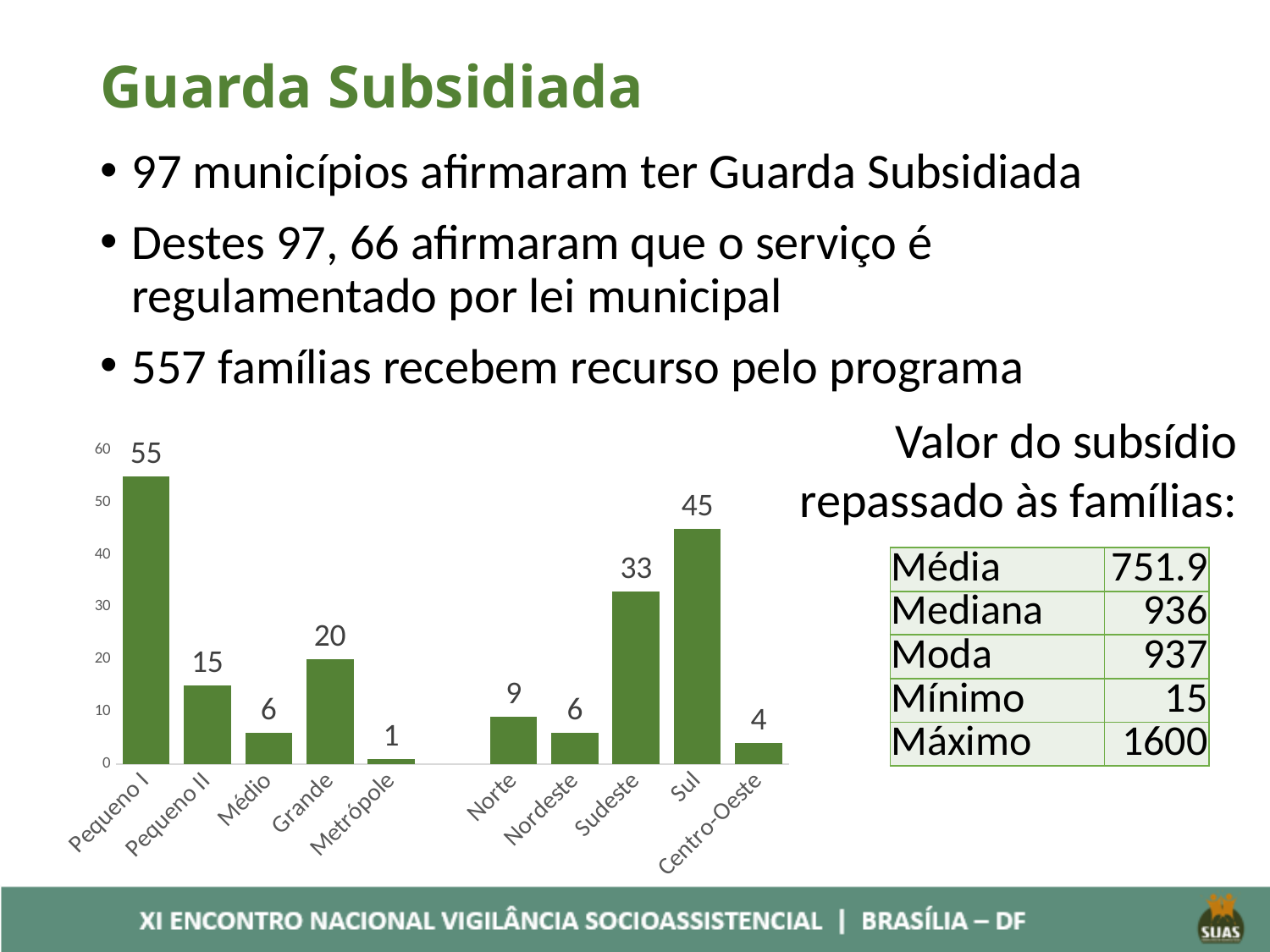
Which category has the lowest value? Metrópole Which is larger, the value for Sudeste or the value for Grande? Sudeste What is the value for Pequeno I? 55 What is the difference between the values for Grande and Pequeno II? 5 What kind of chart is shown on the slide? bar chart What is the value for Sul? 45 Which category has the highest value? Pequeno I Is the value for Norte greater or less than 10? less How many labeled categories are shown on the x axis? 10 What is the value for Metrópole? 1 What is the difference between the values for Pequeno I and Sul? 10 What is the value for Sudeste? 33